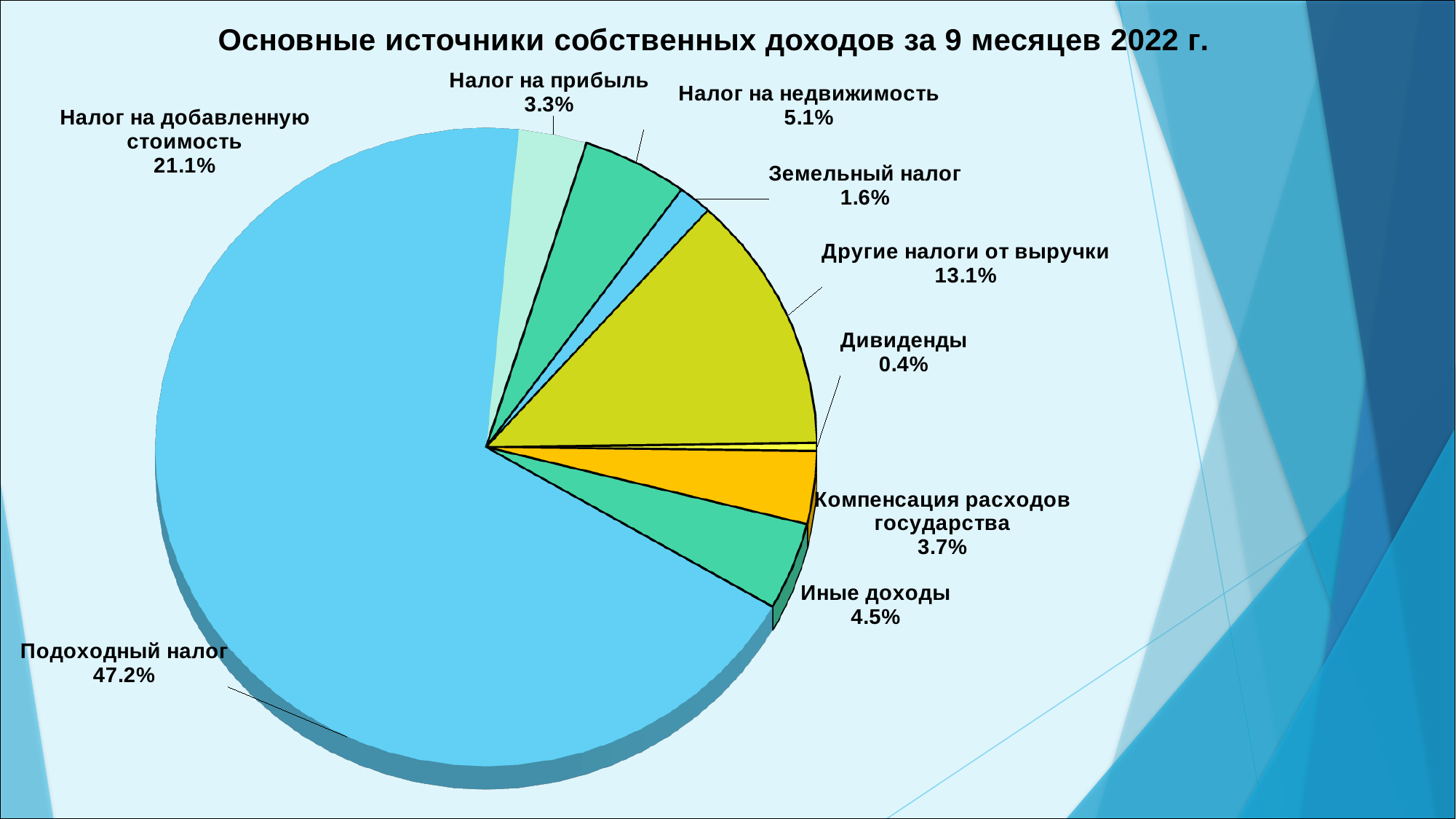
What share does Подоходный налог have in the pie chart? 47.2% Which is larger: the share of Налог на недвижимость or the share of Иные доходы? Налог на недвижимость Which category has the largest share of the pie? Подоходный налог What is the title of the chart? Основные источники собственных доходов за 9 месяцев 2022 г. What is the difference between the shares of Налог на недвижимость and Налог на прибыль? 1.8% What is the value shown for Компенсация расходов государства? 3.7% How many categories (slices) does the pie chart have? 9 What is the value shown for Налог на добавленную стоимость? 21.1% Which category has the smallest share of the pie? Дивиденды What is the difference between the shares of Подоходный налог and Налог на добавленную стоимость? 26.1% What type of chart is shown on the slide? Pie chart What is the value shown for Другие налоги от выручки? 13.1%